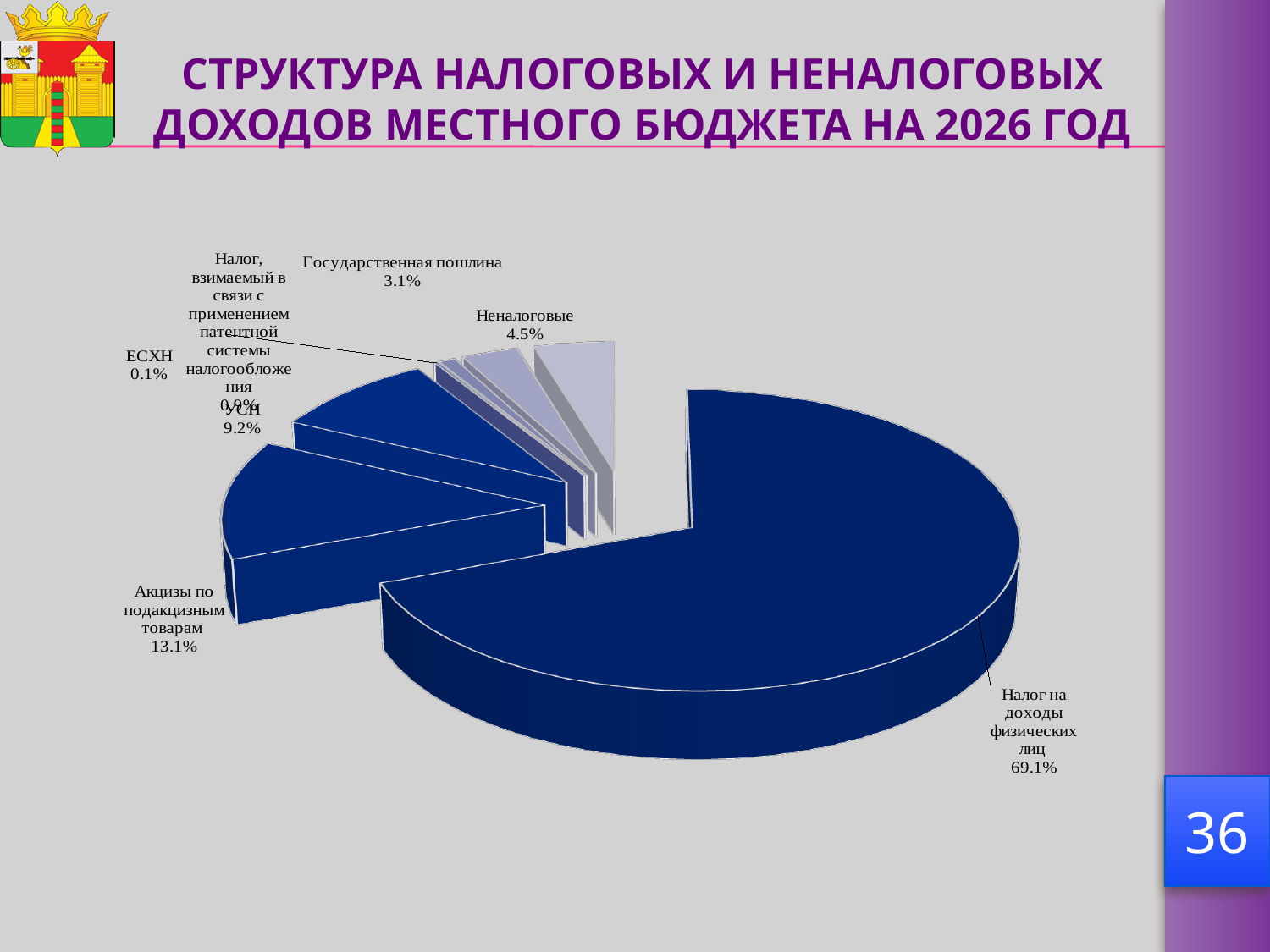
What is the value for "ЕСХН"? 0.1% What is the value for "Акцизы по подакцизным товарам"? 13.1% Which category has the largest share of the pie? Налог на доходы физических лиц What kind of chart is shown on the slide? Pie chart Which is larger: the share of "Неналоговые" or the share of "Государственная пошлина"? Неналоговые What is the value for "Неналоговые"? 4.5% How many slices does the pie chart have? 7 Which category has the smallest share of the pie? ЕСХН What is the value for "УСН"? 9.2% What share of the pie does "Налог на доходы физических лиц" have? 69.1% What is the value for "Государственная пошлина"? 3.1% What is the difference between the shares of "Акцизы по подакцизным товарам" and "УСН"? 3.9%